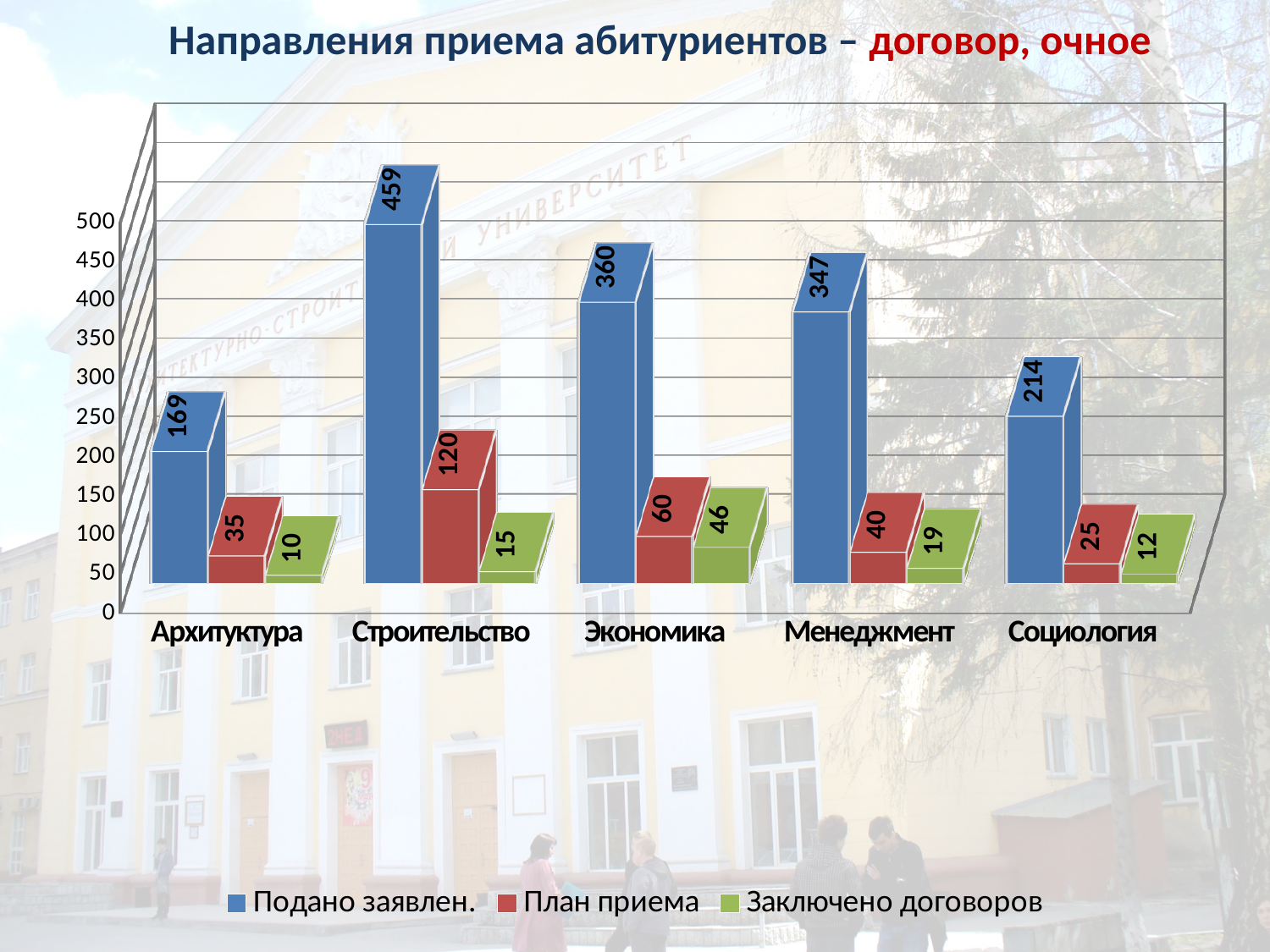
Which category has the highest value for "Подано заявлен."? Строительство How many series does the legend list? 3 Which colour represents "План приема" in the chart? red How many categories are shown on the x axis? 5 What kind of chart is shown on the slide? bar chart What is the value of "План приема" for Экономика? 60 What is the value of "Подано заявлен." for Строительство? 459 What is the difference between "Подано заявлен." and "План приема" for Менеджмент? 307 Which is larger: "Заключено договоров" for Экономика or for Строительство? Экономика Which category has the lowest value for "Заключено договоров"? Архитуктура Is the value of "Подано заявлен." for Социология greater or less than 200? greater What is the value of "Заключено договоров" for Социология? 12